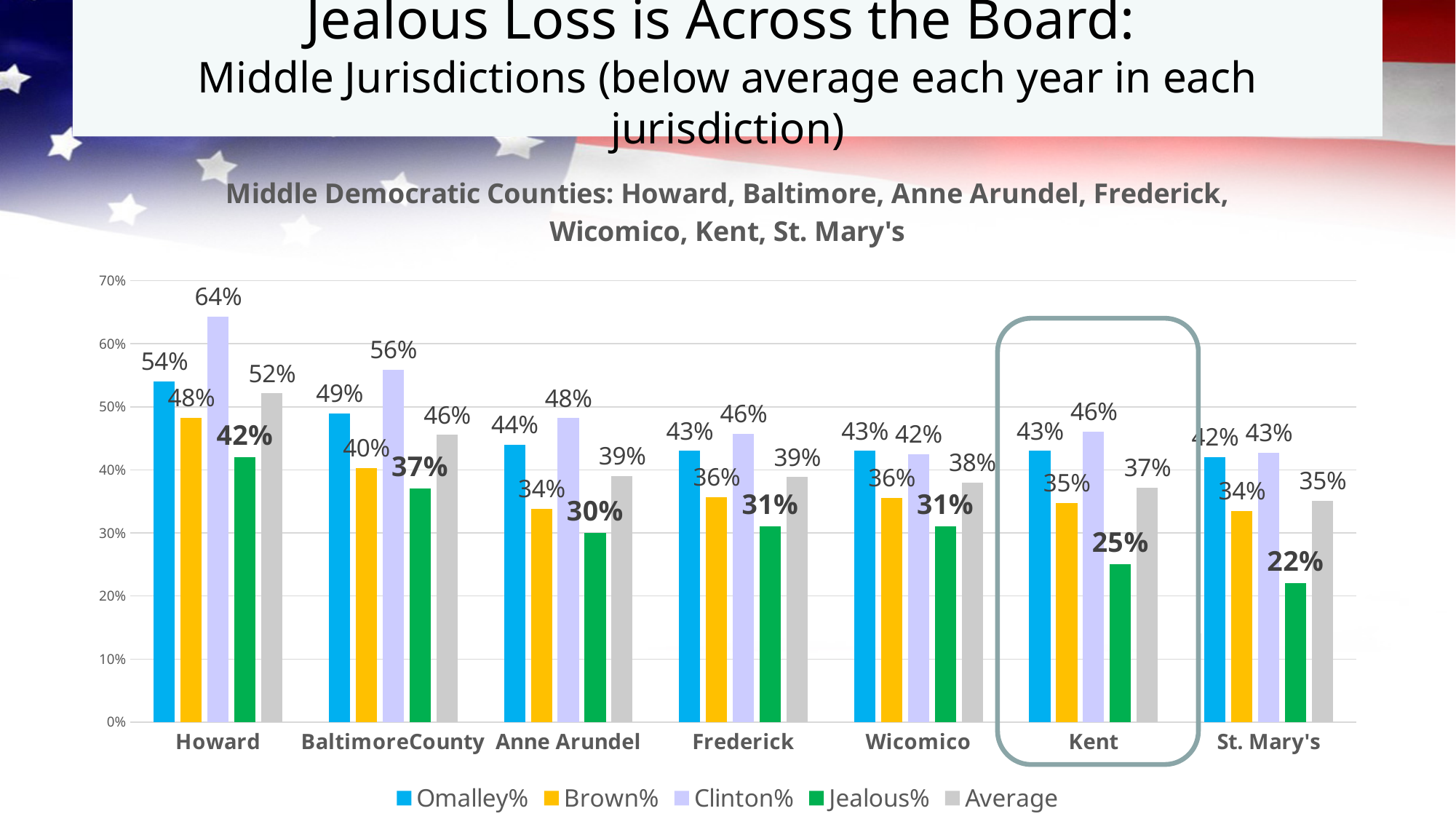
What kind of chart is shown on the slide? Bar chart How many series does the legend list? 5 What is the Jealous% value for Kent? 25% What is the Brown% value for Anne Arundel? 34% Which is larger for Frederick: the Clinton% value or the Omalley% value? Clinton% What is the Average value for Baltimore County? 46% Which county is highlighted with a rounded outline on the chart? Kent What is the difference between the Omalley% and Jealous% values for Howard? 12% What is the Clinton% value for Howard? 64% Which county has the lowest Jealous% value? St. Mary's Which county has the highest Clinton% value? Howard How many counties are shown on the x axis? 7